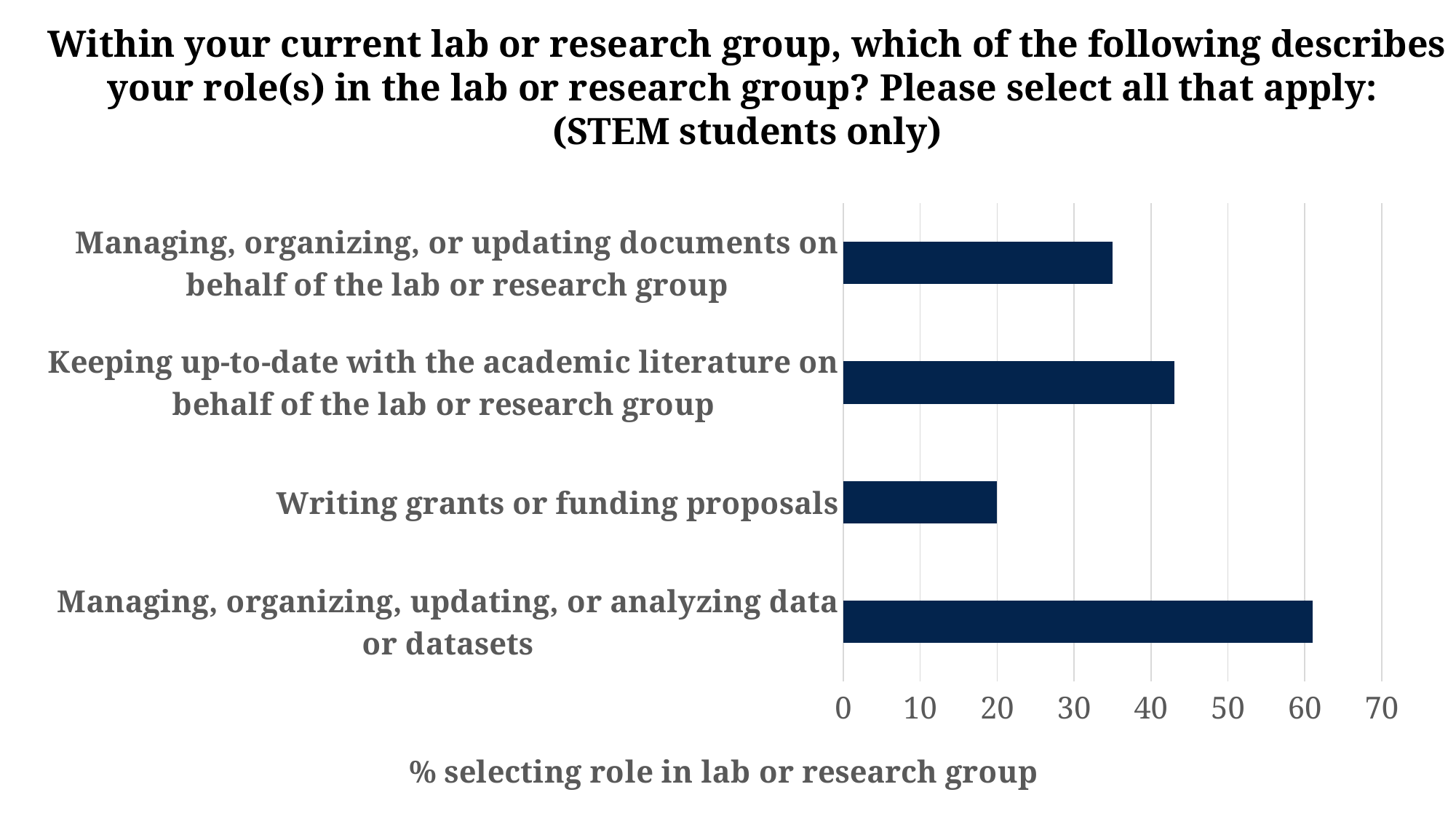
Which role has the highest percentage of STEM students selecting it? Managing, organizing, updating, or analyzing data or datasets Which role has the lowest percentage of STEM students selecting it? Writing grants or funding proposals Which is larger: the value for 'Writing grants or funding proposals' or the value for 'Managing, organizing, updating, or analyzing data or datasets'? Managing, organizing, updating, or analyzing data or datasets How many categories (roles) are plotted in the chart? 4 What is the maximum value shown on the horizontal axis? 70 Is the value for 'Managing, organizing, or updating documents on behalf of the lab or research group' greater or less than 40? less What is the label on the horizontal axis of the chart? % selecting role in lab or research group Is the value for 'Writing grants or funding proposals' greater or less than 30? less Is the value for 'Keeping up-to-date with the academic literature on behalf of the lab or research group' greater or less than 40? greater What kind of chart is shown on the slide? bar chart Which is larger: the value for 'Keeping up-to-date with the academic literature on behalf of the lab or research group' or the value for 'Managing, organizing, or updating documents on behalf of the lab or research group'? Keeping up-to-date with the academic literature on behalf of the lab or research group